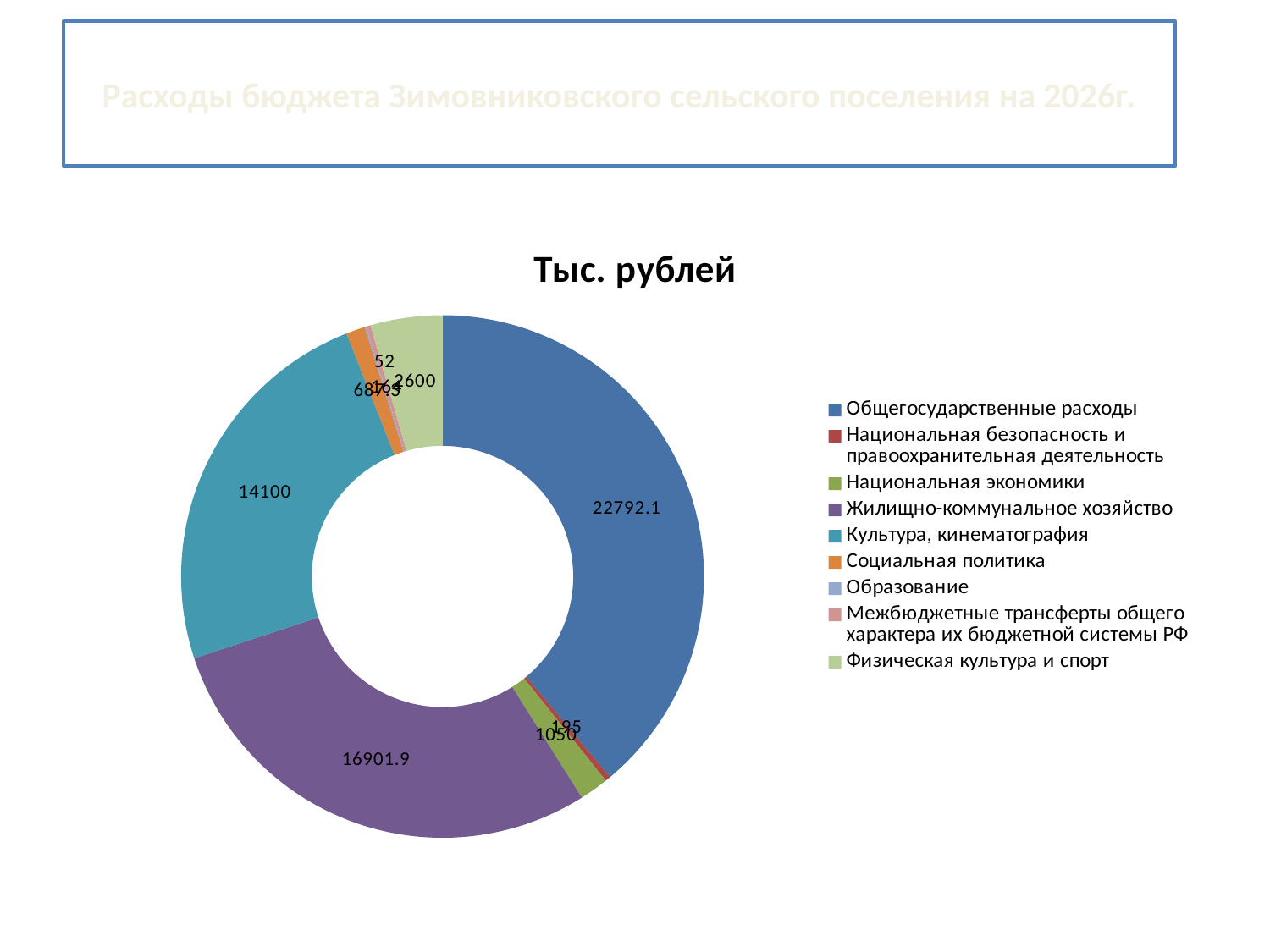
How many categories does the legend list? 9 What is the difference between Жилищно-коммунальное хозяйство and Культура, кинематография? 2801.9 What is the value for Национальная экономики? 1050 What is the value for Общегосударственные расходы? 22792.1 What is the value for Физическая культура и спорт? 2600 What kind of chart is shown on the slide? doughnut (pie) chart What is the value for Жилищно-коммунальное хозяйство? 16901.9 Which is larger: Жилищно-коммунальное хозяйство or Культура, кинематография? Жилищно-коммунальное хозяйство What is the title of the chart? Тыс. рублей What is the difference between Общегосударственные расходы and Жилищно-коммунальное хозяйство? 5890.2 What is the value for Культура, кинематография? 14100 Which category has the largest value? Общегосударственные расходы